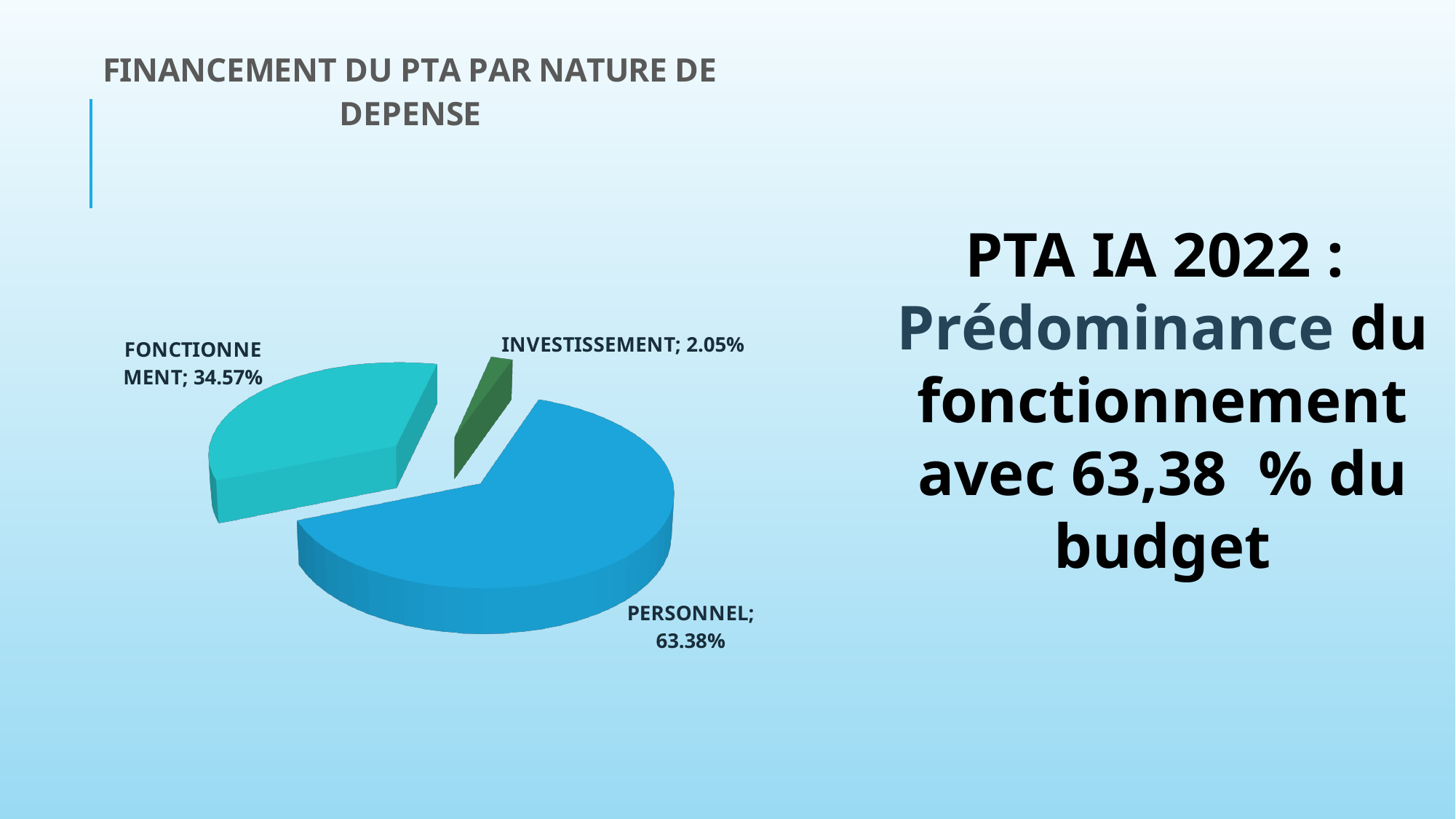
What share of the pie does INVESTISSEMENT represent? 2.05% Which category has the smallest slice of the pie? INVESTISSEMENT What kind of chart is shown on the slide? Pie chart What colour is the INVESTISSEMENT slice? Green How many categories are shown in the pie chart? 3 What share of the pie does FONCTIONNEMENT represent? 34.57% What is the difference in percentage points between PERSONNEL and FONCTIONNEMENT? 28.81 Which is larger, the share for FONCTIONNEMENT or the share for INVESTISSEMENT? FONCTIONNEMENT What is the difference in percentage points between FONCTIONNEMENT and INVESTISSEMENT? 32.52 What is the title of the chart? FINANCEMENT DU PTA PAR NATURE DE DEPENSE What share of the pie does PERSONNEL represent? 63.38% Which category has the largest slice of the pie? PERSONNEL